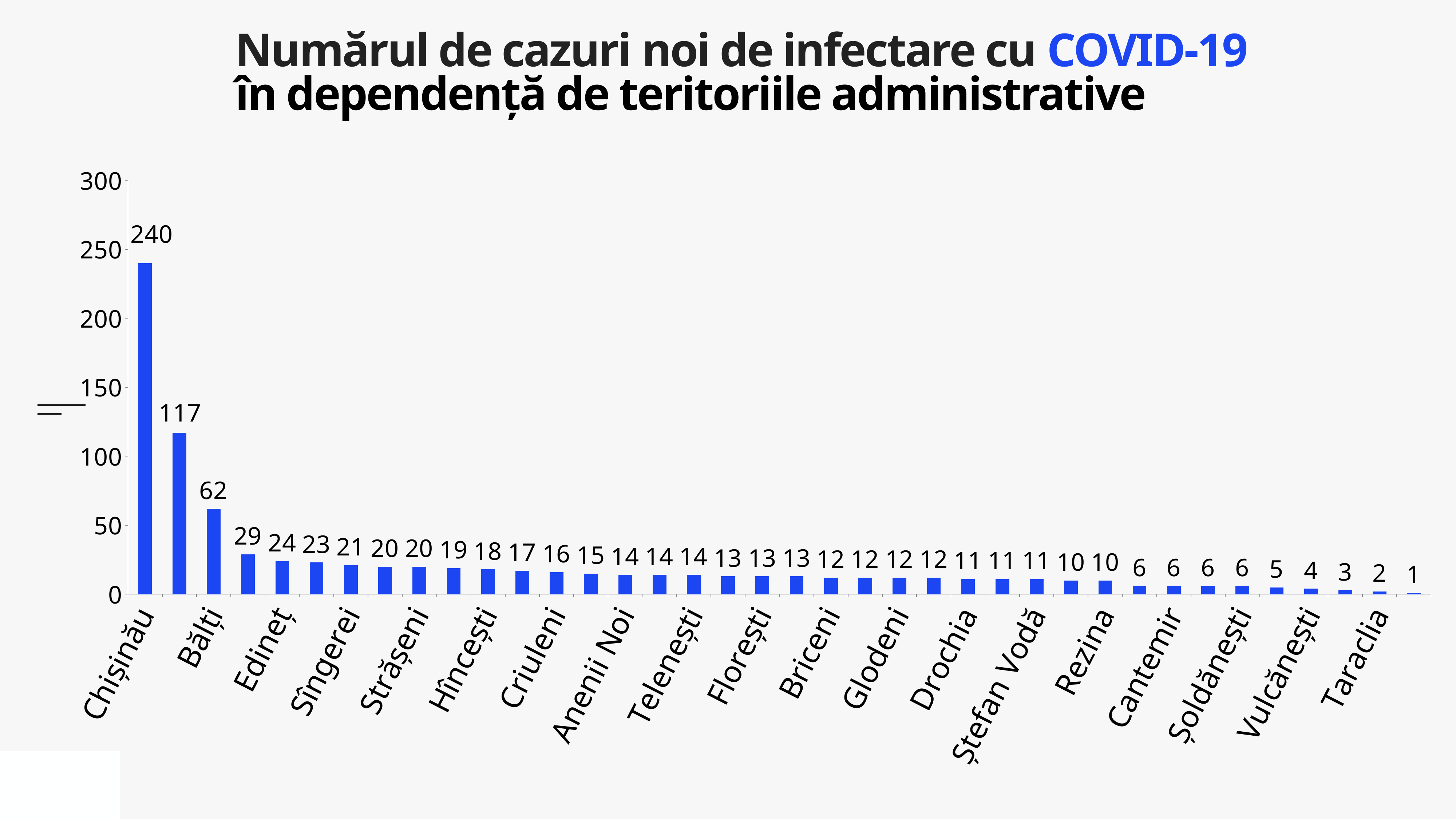
Which has more new cases, Chișinău or Taraclia? Chișinău What is the difference between the highest value (240) and the second-highest value (117)? 123 Do the values rise or fall from left to right along the x axis? fall What is the second-highest value shown on the chart? 117 What is the lowest value printed on the chart? 1 What is the highest value shown on the chart? 240 What is the value of the bar for Chișinău? 240 Is the value for Chișinău greater or less than 200? greater What is the maximum value shown on the vertical axis? 300 What kind of chart is shown on the slide? bar chart What colour are the bars in the chart? blue Which territory has the highest number of new cases? Chișinău